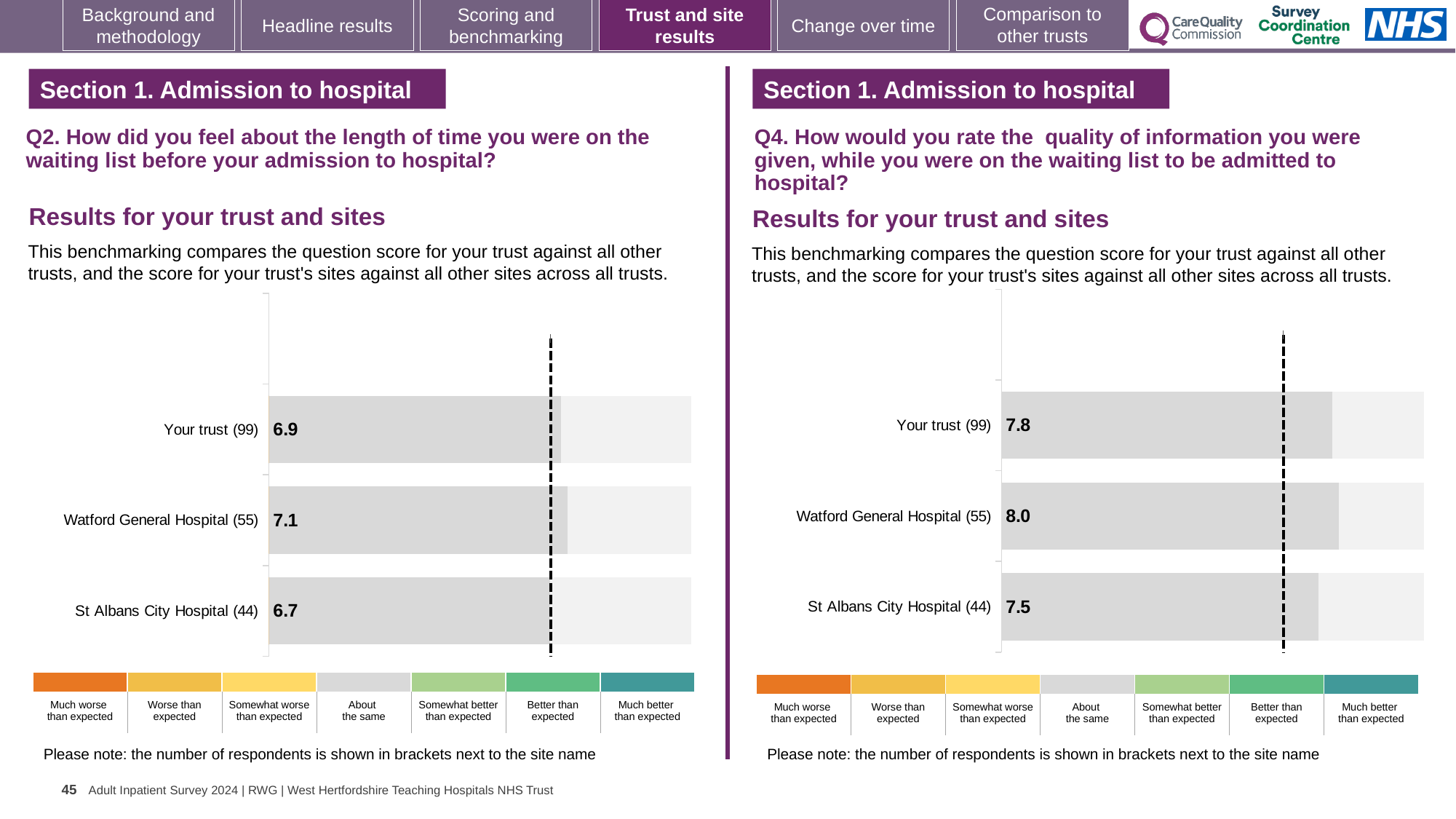
In the Q4 chart on the right, what is the difference between the scores for Watford General Hospital and Your trust? 0.2 In the Q2 chart on the left, which site or trust has the lowest score? St Albans City Hospital In the Q2 chart on the left, which site or trust has the highest score? Watford General Hospital How many categories (trust and sites) are plotted in the Q2 chart on the left? 3 In the Q2 chart on the left, what is the difference between the scores for Watford General Hospital and St Albans City Hospital? 0.4 In the Q2 chart on the left, what is the score for St Albans City Hospital? 6.7 In the Q4 chart on the right, what is the score for Your trust? 7.8 In the Q2 chart on the left, what is the score for Your trust? 6.9 In the Q4 chart on the right, which site or trust has the lowest score? St Albans City Hospital In the Q4 chart on the right, what is the score for Watford General Hospital? 8.0 In the Q4 chart on the right, what is the score for St Albans City Hospital? 7.5 In the Q2 chart on the left, what is the score for Watford General Hospital? 7.1